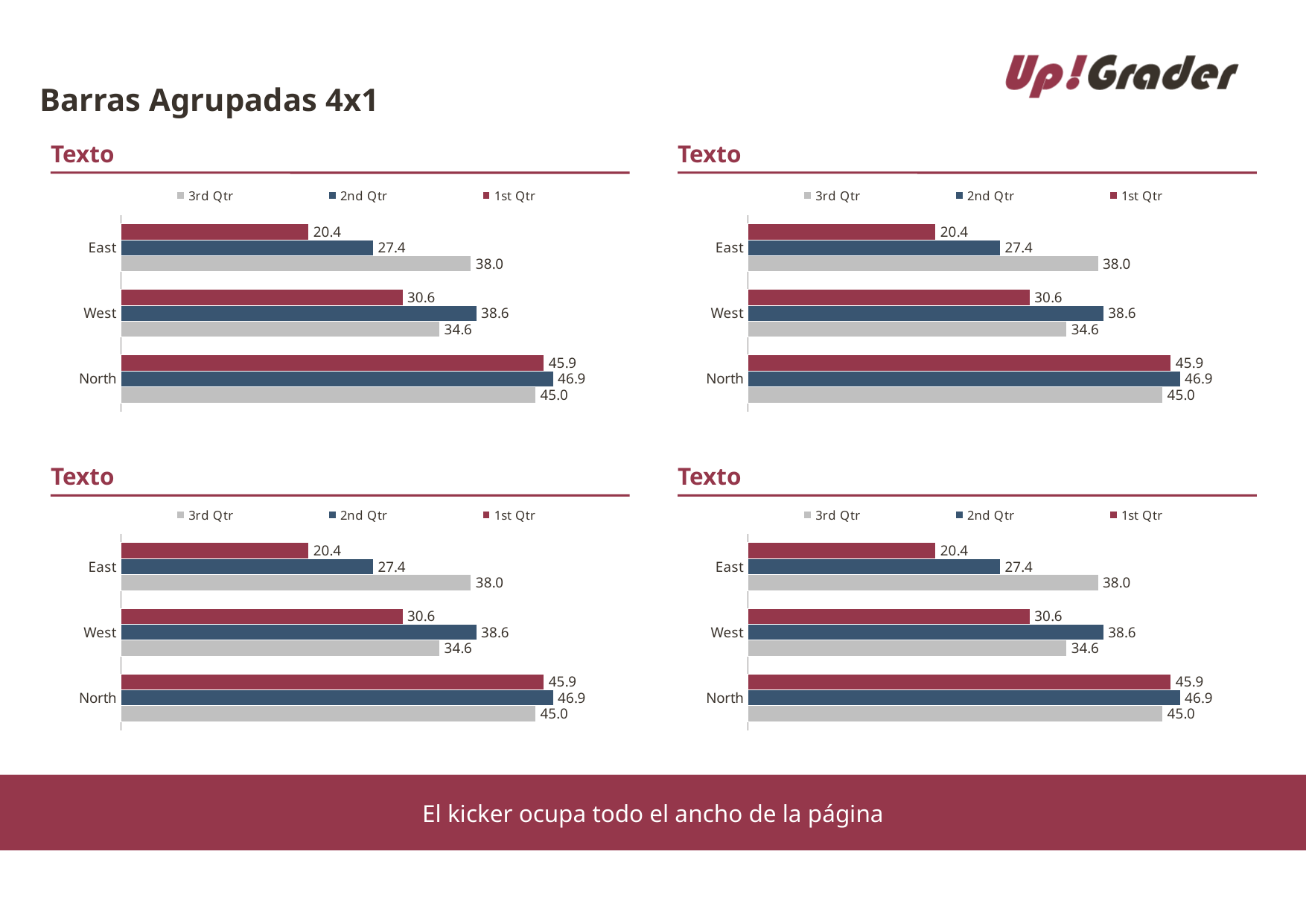
In the top-left chart, which category has the lowest 2nd Qtr value? East In the top-left chart, what is the 1st Qtr value for East? 20.4 In the top-left chart, how many series does the legend list? 3 In the bottom-right chart, which category has the highest 1st Qtr value? North What type of chart is the top-right chart? Bar chart In the bottom-left chart, what is the 3rd Qtr value for North? 45.0 In the top-right chart, what is the difference between the 3rd Qtr and 1st Qtr values for East? 17.6 In the bottom-right chart, how many categories are shown on the vertical axis? 3 In the top-right chart, what is the 2nd Qtr value for West? 38.6 In the bottom-right chart, which series is shown in grey? 3rd Qtr In the bottom-left chart, which is larger for West: the 2nd Qtr value or the 3rd Qtr value? 2nd Qtr In the bottom-left chart, what is the difference between the 2nd Qtr values for North and West? 8.3